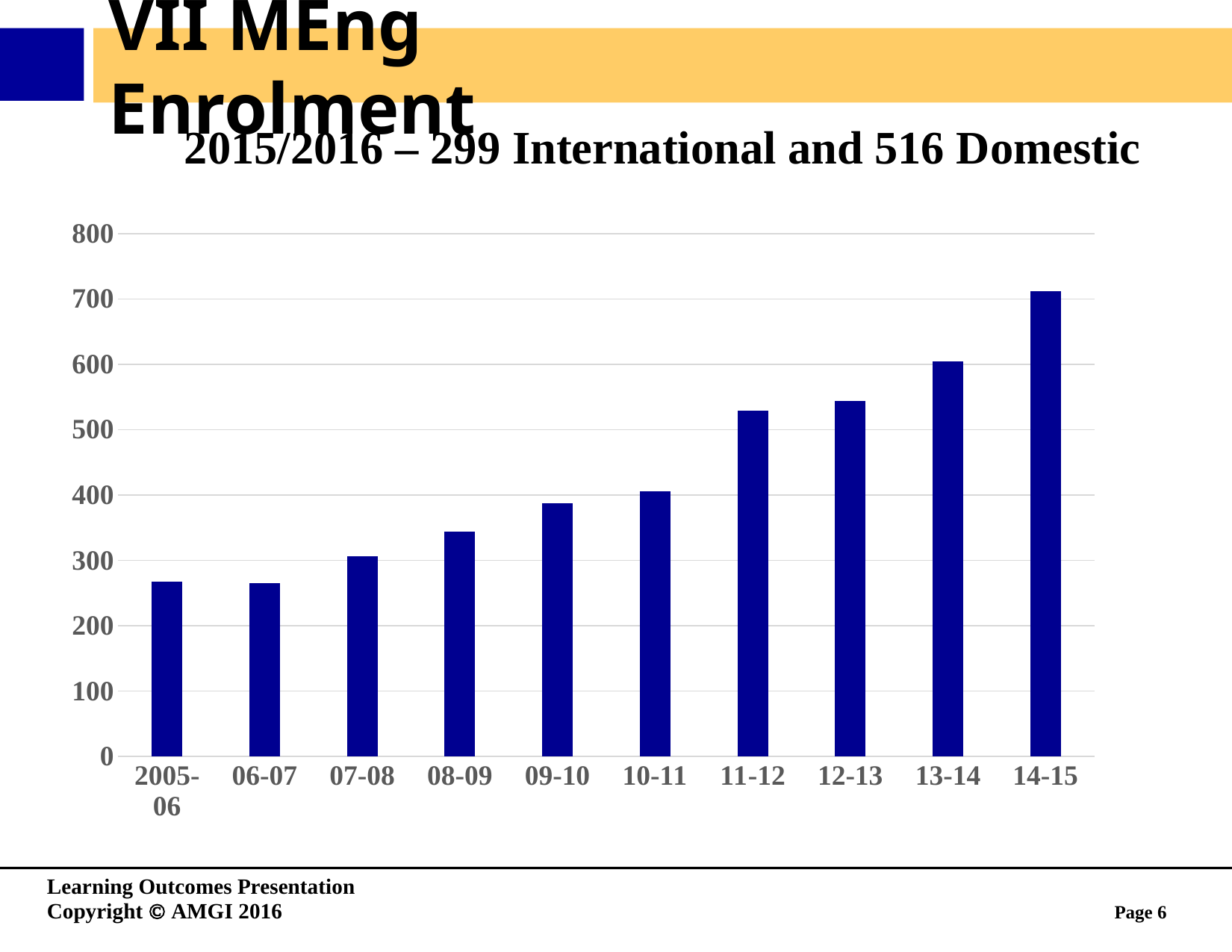
Is the value for 09-10 greater or less than 400? less Is the value for 14-15 greater or less than 700? greater According to the chart's subtitle, how many international students were enrolled in 2015/2016? 299 Is the value for 11-12 greater or less than 500? greater Which academic year has the highest enrolment on the chart? 14-15 How many academic years (bars) are shown on the chart? 10 Which is larger, the value for 10-11 or the value for 11-12? 11-12 Do the enrolment values generally rise or fall from 2005-06 to 14-15? rise What kind of chart is shown on the slide? bar chart